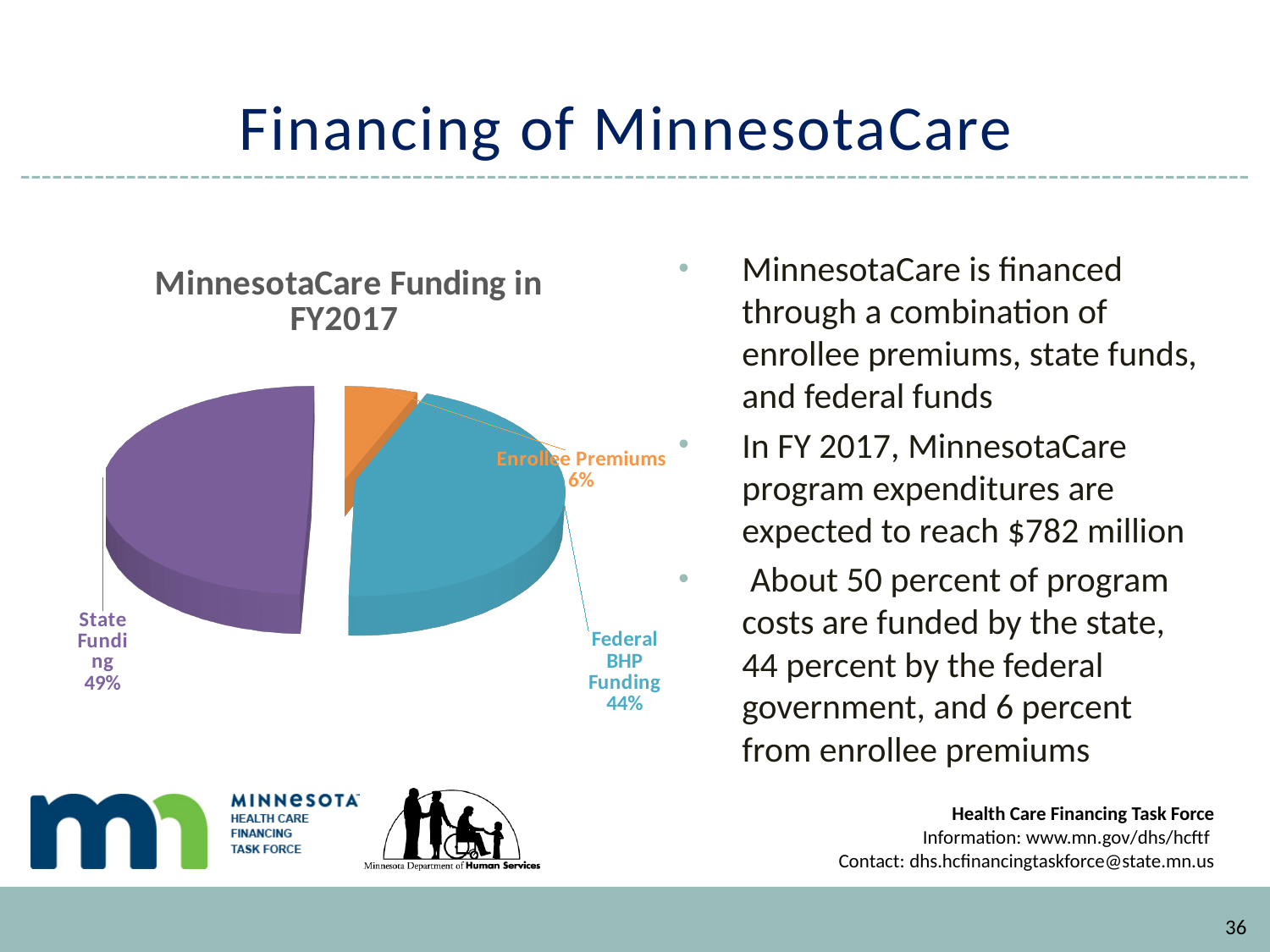
What is the difference in percentage points between State Funding and Federal BHP Funding? 5 percentage points What share of MinnesotaCare funding in FY2017 comes from Federal BHP Funding? 44% What share of MinnesotaCare funding in FY2017 comes from Enrollee Premiums? 6% What kind of chart is shown on the slide? Pie chart What share of MinnesotaCare funding in FY2017 comes from State Funding? 49% Which funding source has the smallest share of the pie? Enrollee Premiums How many slices does the pie chart have? 3 What is the difference in percentage points between Federal BHP Funding and Enrollee Premiums? 38 percentage points Which is larger, the share for Federal BHP Funding or the share for Enrollee Premiums? Federal BHP Funding What is the title of the chart? MinnesotaCare Funding in FY2017 What colour is the State Funding slice of the pie? Purple Which funding source has the largest share of the pie? State Funding